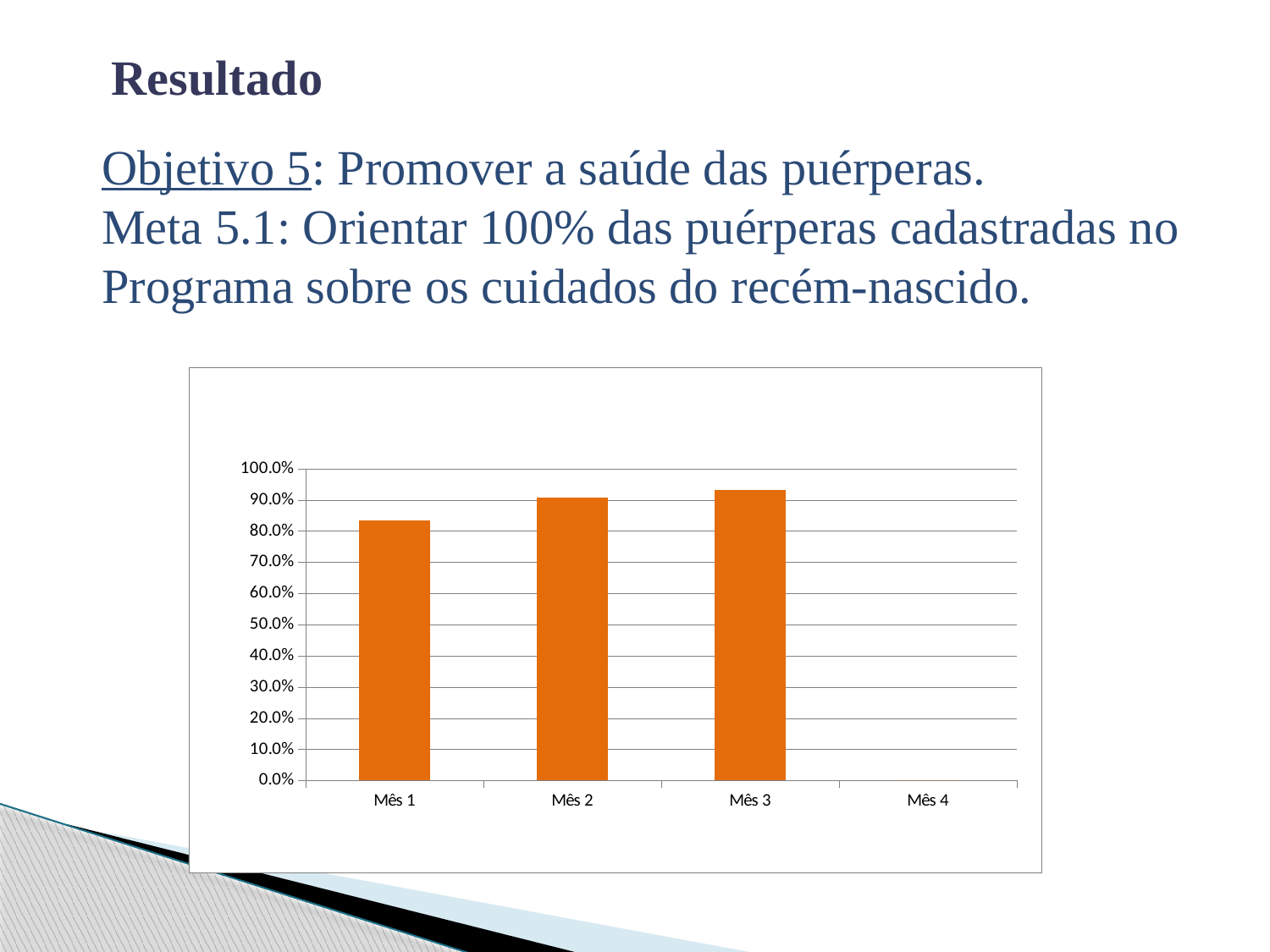
Which is larger, the value for Mês 1 or the value for Mês 2? Mês 2 Which is larger, the value for Mês 3 or the value for Mês 4? Mês 3 Is the value for Mês 1 greater or less than 70.0%? greater Is the value for Mês 2 greater or less than 80.0%? greater What kind of chart is shown on the slide? bar chart Is the value for Mês 1 greater or less than 90.0%? less What colour are the bars in the chart? orange Do the values rise or fall from Mês 1 to Mês 3? rise How many categories are shown on the x axis of the chart? 4 Which category has the lowest value in the chart? Mês 4